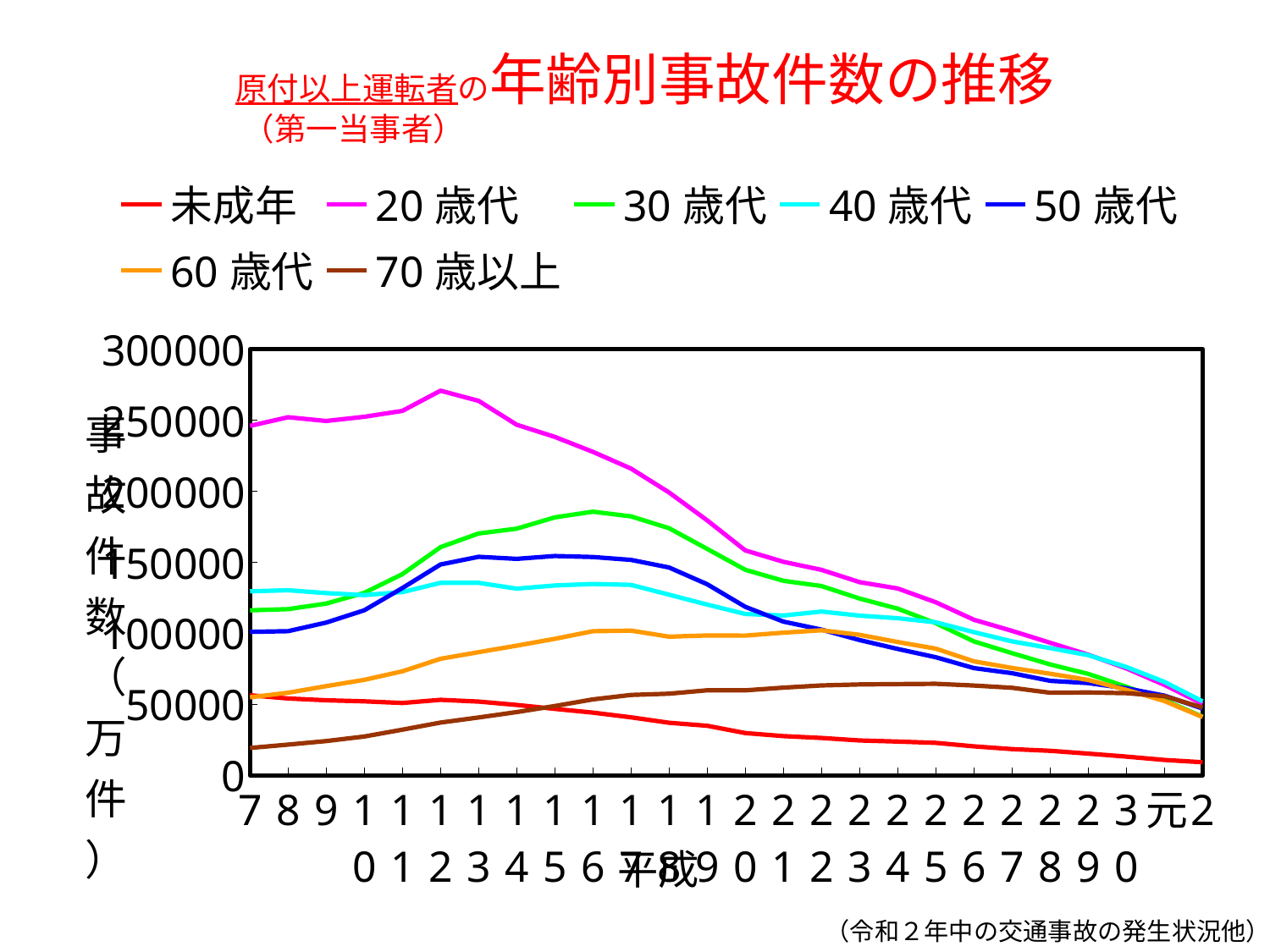
Is the value for 70歳以上 at 平成7 greater or less than 50000? less What kind of chart is shown on the slide? line chart At 平成7, which is larger: the value for 40歳代 or the value for 50歳代? 40歳代 Does the 20歳代 line rise or fall overall from 平成12 to 令和2? fall Which series has the highest value at 平成7? 20歳代 Does the 70歳以上 line rise or fall overall from 平成7 to 平成25? rise How many series does the legend list? 7 Is the value for 未成年 at 令和2 greater or less than 50000? less What is the highest tick value shown on the vertical axis? 300000 Is the value for 20歳代 at 平成12 greater or less than 250000? greater Which series has the lowest value at 平成7? 70歳以上